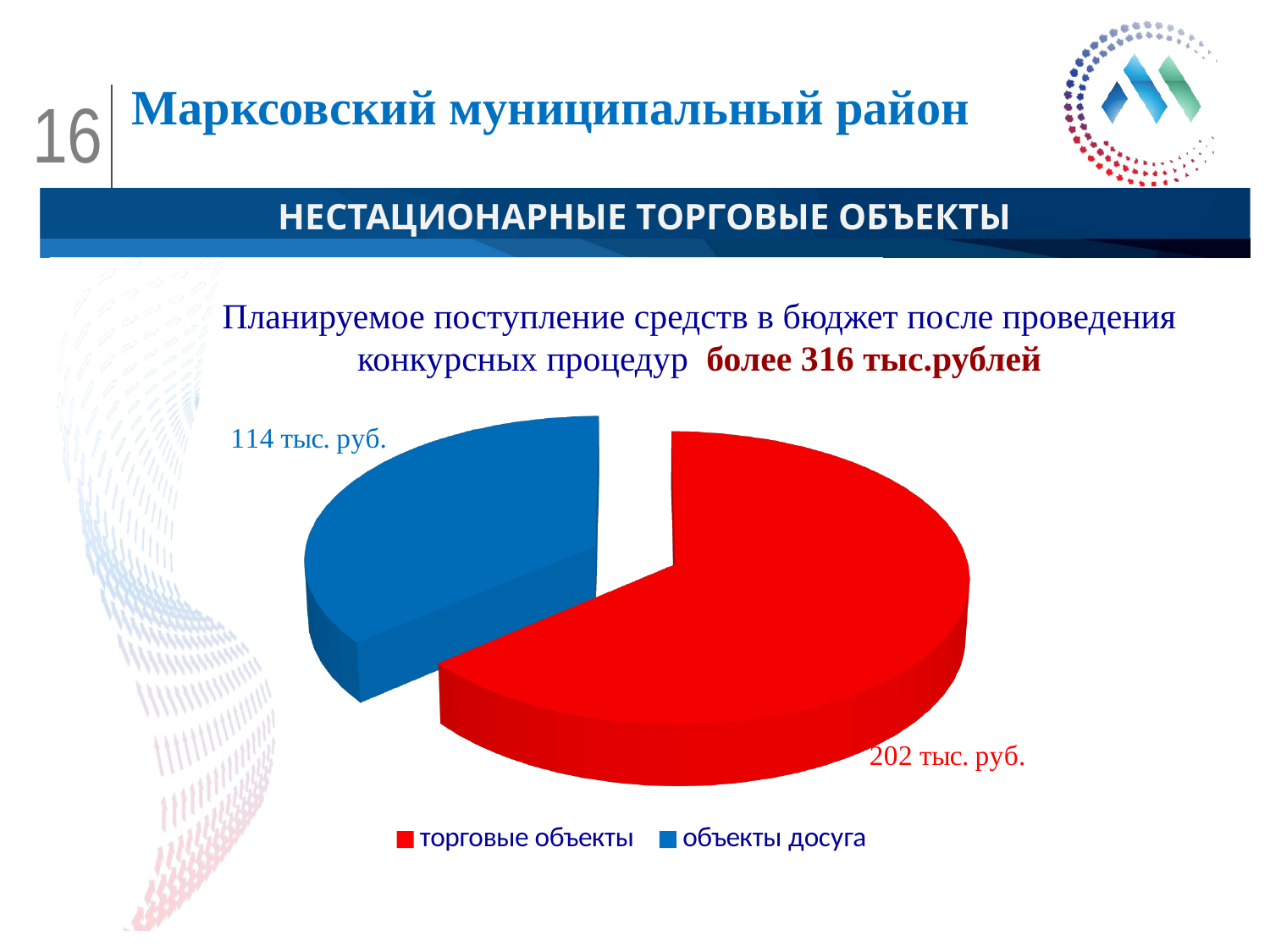
What is the difference between the values for торговые объекты and объекты досуга? 88 тыс. руб. Which category has the smallest slice of the pie? объекты досуга Which is larger, the value for торговые объекты or the value for объекты досуга? торговые объекты What is the value for объекты досуга? 114 тыс. руб. How many slices does the pie chart have? 2 What colour is the slice for объекты досуга? blue What colour is the slice for торговые объекты? red What is the total of the two slices in the pie chart? 316 тыс. руб. What kind of chart is shown on the slide? pie chart Which category has the largest slice of the pie? торговые объекты What is the value for торговые объекты? 202 тыс. руб. How many entries does the legend list? 2